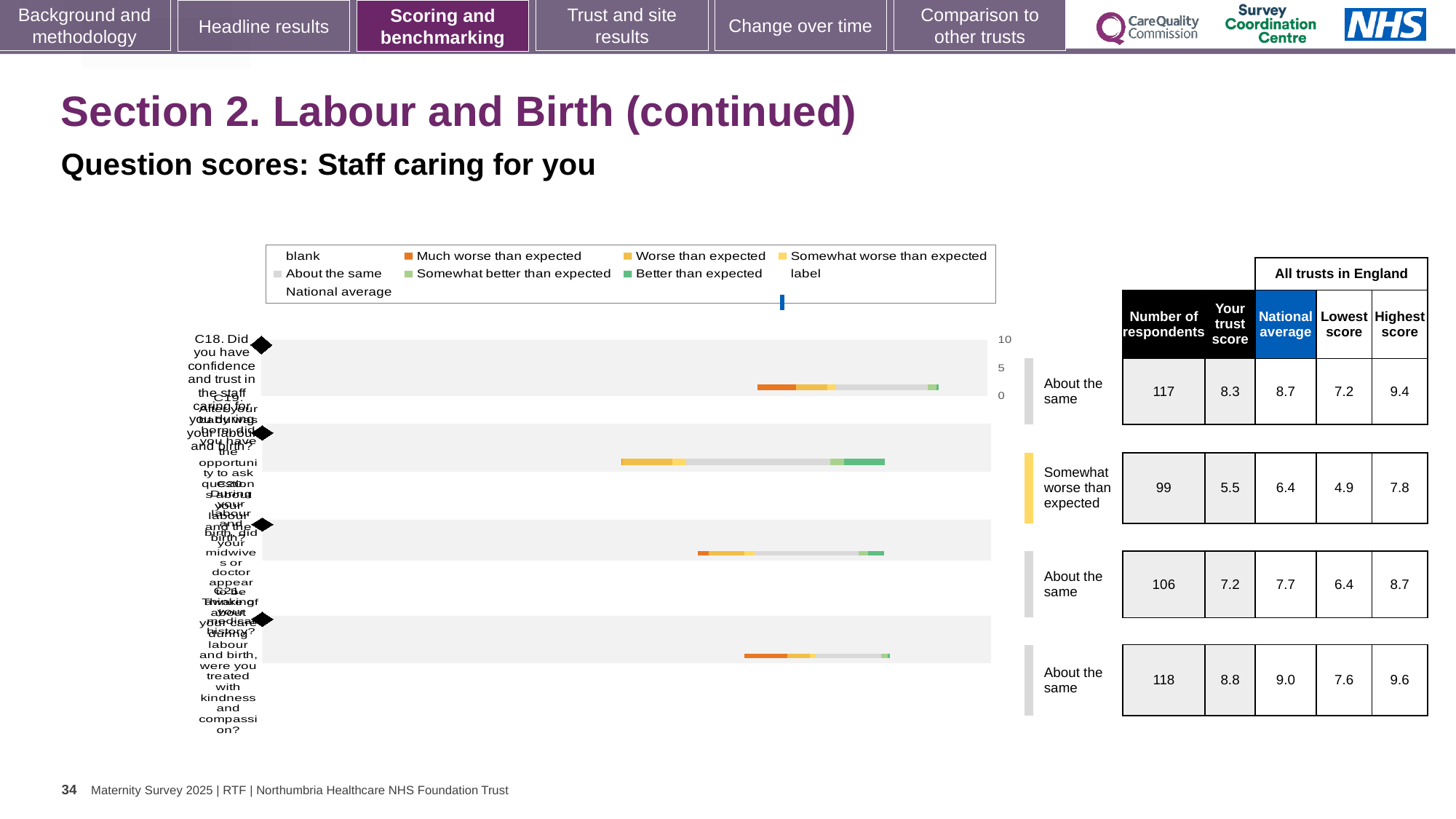
Which benchmark rating is given to the second row of the chart? Somewhat worse than expected What is the lowest score across all trusts in England for the third row? 6.4 Which row has the highest 'Your trust score'? the fourth (bottom) row, 8.8 How many respondents are there for the row rated 'Somewhat worse than expected'? 99 How many question rows are plotted in the chart? 4 What kind of chart is shown on the slide? bar chart Which is larger: the trust score for the first row (C18) or the trust score for the third row? the first row (C18) For the second row, how much higher is the national average than the trust score? 0.9 What is the highest score across all trusts in England for the fourth (bottom) row? 9.6 What is the national average for the second row of the chart? 6.4 Which row has the lowest 'Your trust score'? the second row, 5.5 What is the 'Your trust score' for the first (top) row, question C18? 8.3